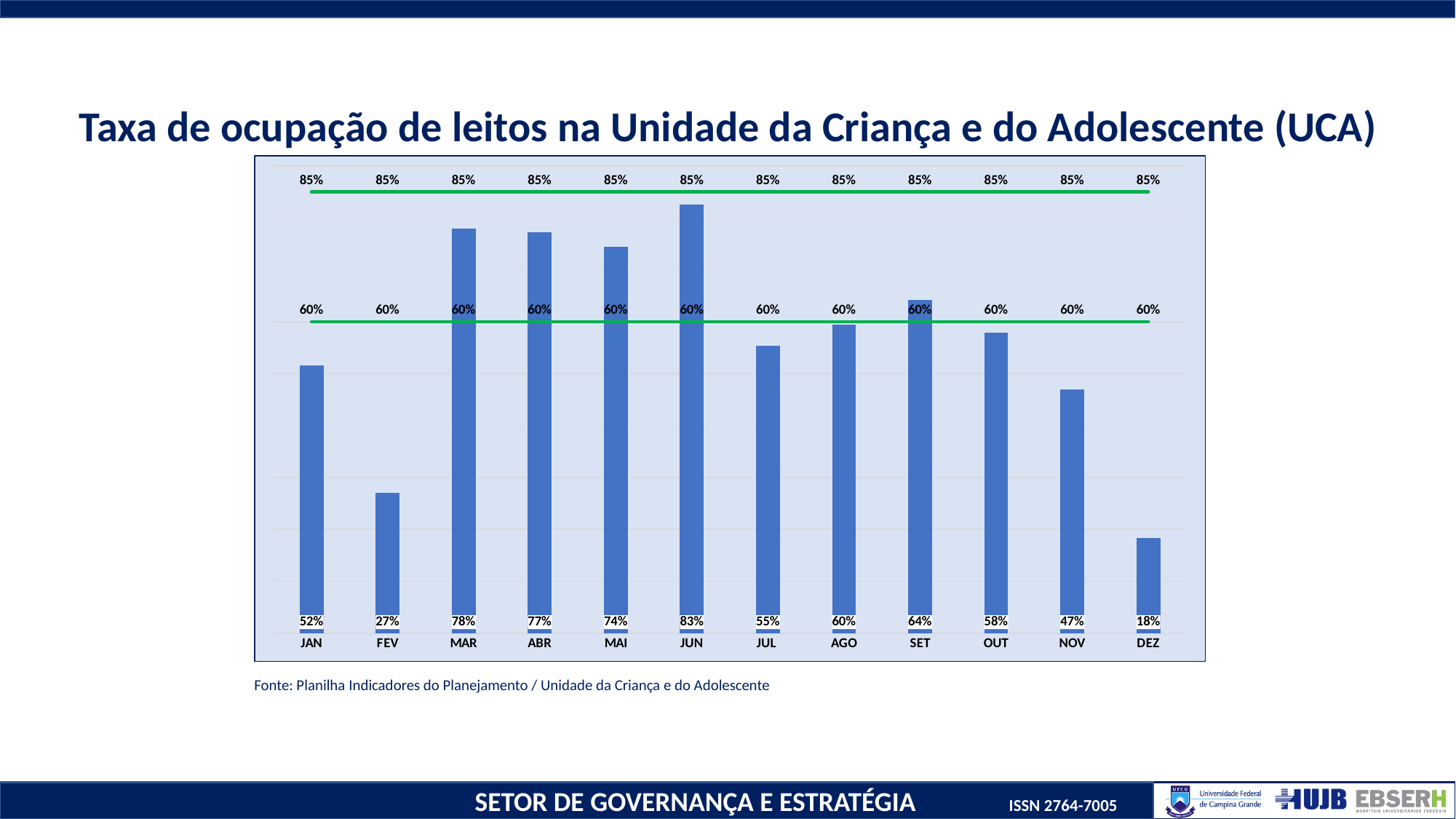
What kind of chart is used to show the monthly occupancy rates? Bar chart What is the bed occupancy rate shown for JUN? 83% What is the bed occupancy rate shown for FEV? 27% Do the occupancy rates rise or fall from SET to DEZ? Fall How many months are shown on the x axis of the chart? 12 Which month has the highest bed occupancy rate? JUN Which month has a higher occupancy rate, SET or OUT? SET What is the title of the chart? Taxa de ocupação de leitos na Unidade da Criança e do Adolescente (UCA) What is the bed occupancy rate shown for DEZ? 18% What are the two constant reference values marked by the green lines on the chart? 85% and 60% What is the difference between the occupancy rates for MAR and JAN? 26% Which month has the lowest bed occupancy rate? DEZ